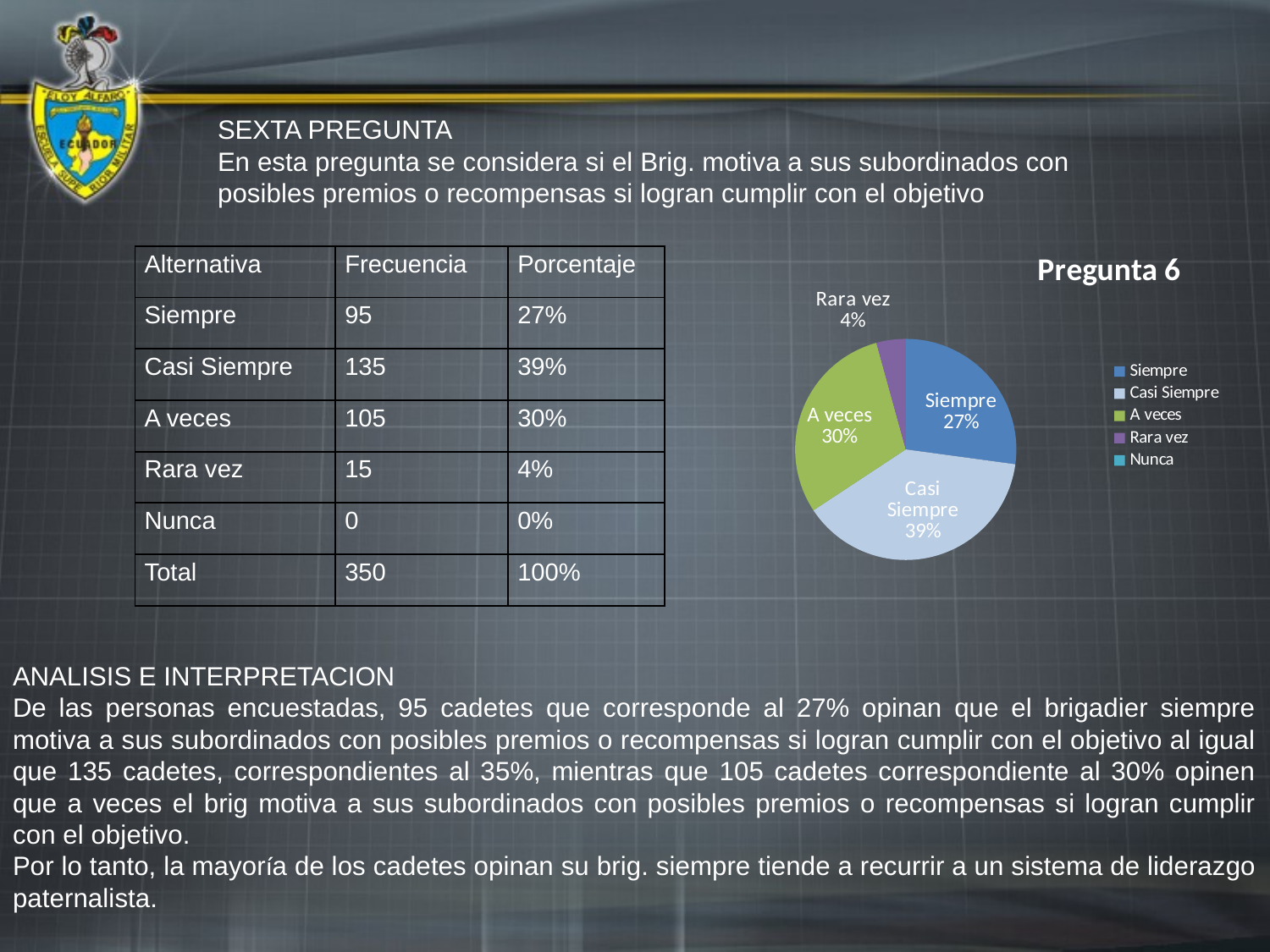
Which slice is larger in the pie chart, A veces or Siempre? A veces How many entries does the legend of the pie chart list? 5 What is the title of the chart? Pregunta 6 What is the difference in percentage points between the Casi Siempre and Siempre slices? 12 What percentage does the Siempre slice show in the pie chart? 27% Which category has the largest slice in the pie chart? Casi Siempre What colour is the A veces slice in the pie chart? green What kind of chart is shown on the slide? pie chart What percentage does the Casi Siempre slice show in the pie chart? 39% What percentage does the A veces slice show in the pie chart? 30% Which labelled slice in the pie chart is the smallest? Rara vez What percentage does the Rara vez slice show in the pie chart? 4%